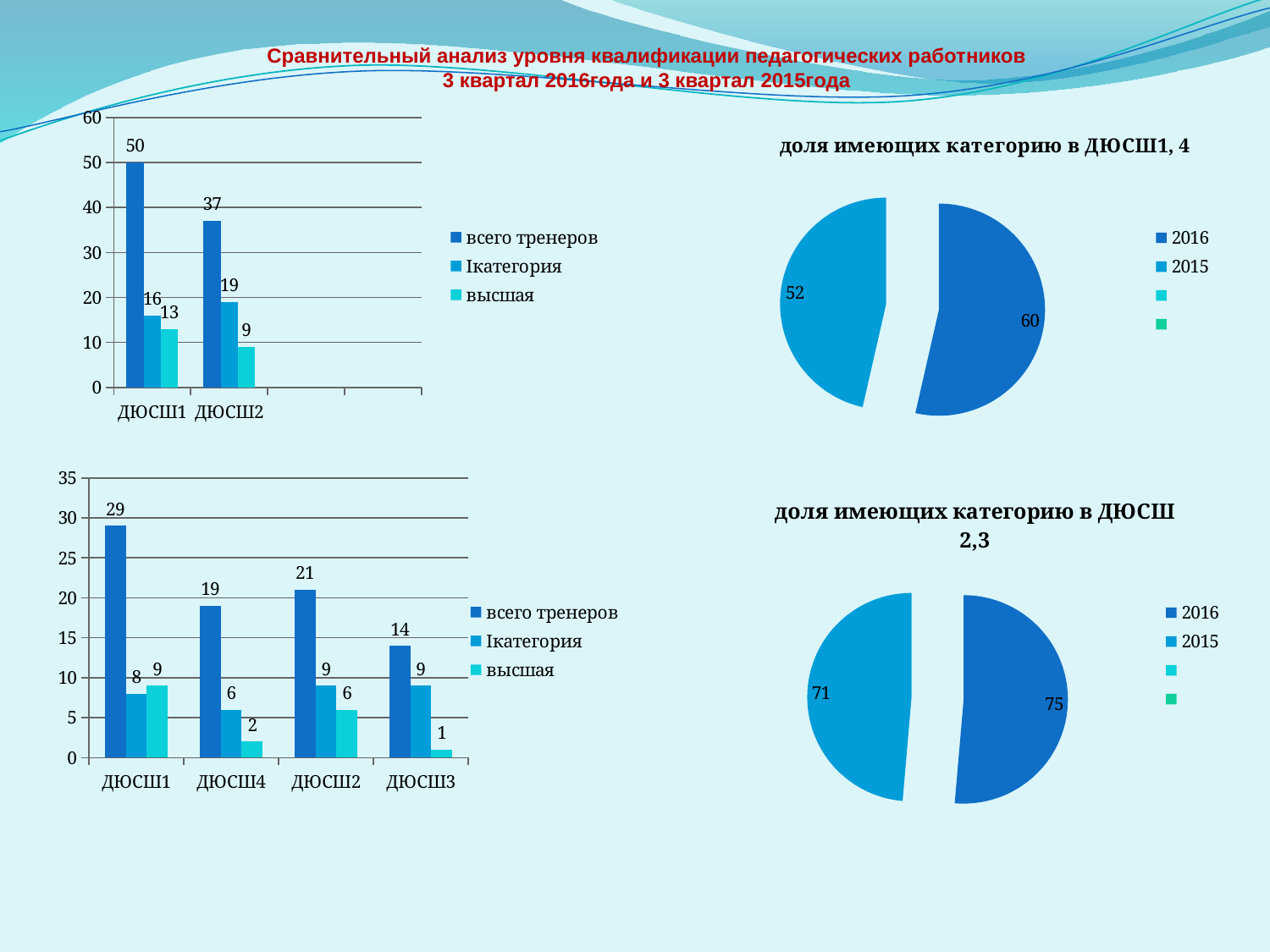
In the top-left bar chart, what is the value of высшая for ДЮСШ2? 9 How many categories are shown on the x axis of the bottom-left bar chart? 4 In the bottom-left bar chart, which category has the lowest value for высшая? ДЮСШ3 How many series does the legend of the top-left bar chart list? 3 In the bottom-left bar chart, is the value of высшая for ДЮСШ4 larger or smaller than the value of высшая for ДЮСШ2? smaller What kind of chart is the chart in the bottom-right of the slide? pie chart In the pie chart titled 'доля имеющих категорию в ДЮСШ1, 4', what is the value for 2016? 60 In the bottom-left bar chart, what is the value of Iкатегория for ДЮСШ2? 9 In the pie chart titled 'доля имеющих категорию в ДЮСШ 2,3', what is the value for 2015? 71 In the top-left bar chart, what is the value of всего тренеров for ДЮСШ1? 50 In the bottom-left bar chart, which category has the highest value for всего тренеров? ДЮСШ1 In the top-left bar chart, what is the difference between всего тренеров for ДЮСШ1 and for ДЮСШ2? 13